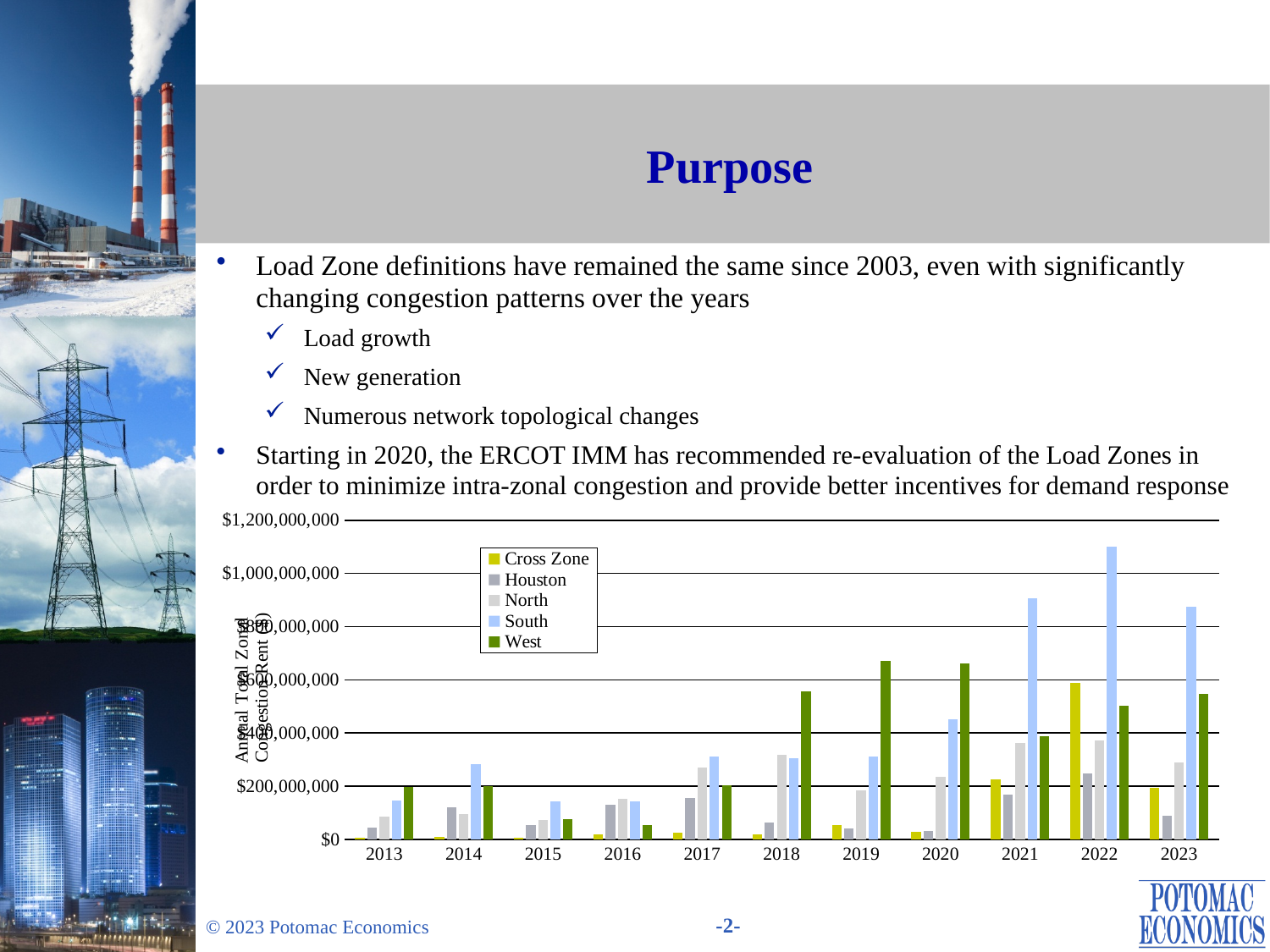
Which series has the shortest bar in 2022? Houston Which is larger, the South bar in 2022 or the West bar in 2022? South How many years are shown on the x axis of the chart? 11 Is the value for South in 2022 greater or less than $1,000,000,000? greater How many series does the chart's legend list? 5 Which series has the tallest bar in 2022? South What kind of chart is shown on the slide? bar chart Is the value for Houston in 2014 greater or less than $200,000,000? less Which series has the tallest bar in 2019? West Is the value for West in 2018 greater or less than $600,000,000? less In which year is the South bar the tallest? 2022 Which series is listed first in the chart's legend? Cross Zone